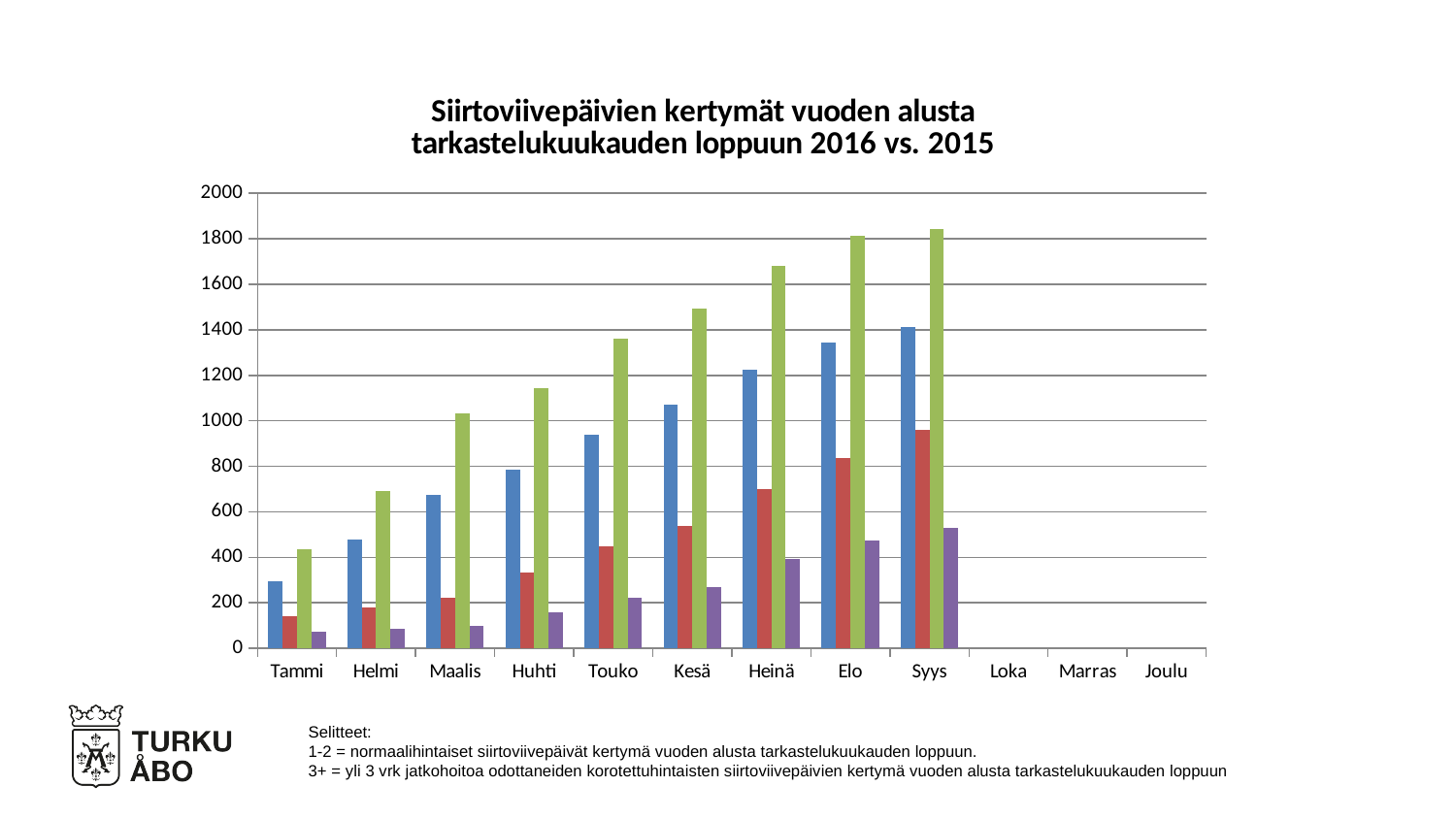
For Syys, which is larger: the green bar or the blue bar? the green bar What is the title of the chart? Siirtoviivepäivien kertymät vuoden alusta tarkastelukuukauden loppuun 2016 vs. 2015 Among the green bars, which month has the highest value? Syys Which months on the x axis have no bars plotted? Loka, Marras, Joulu Is the value of the red bar for Tammi greater or less than 200? less Is the value of the green bar for Syys greater or less than 1800? greater Is the value of the purple bar for Syys greater or less than 400? greater Do the green bars rise or fall from Tammi to Syys? rise What kind of chart is shown on the slide? bar chart How many month categories are listed along the x axis? 12